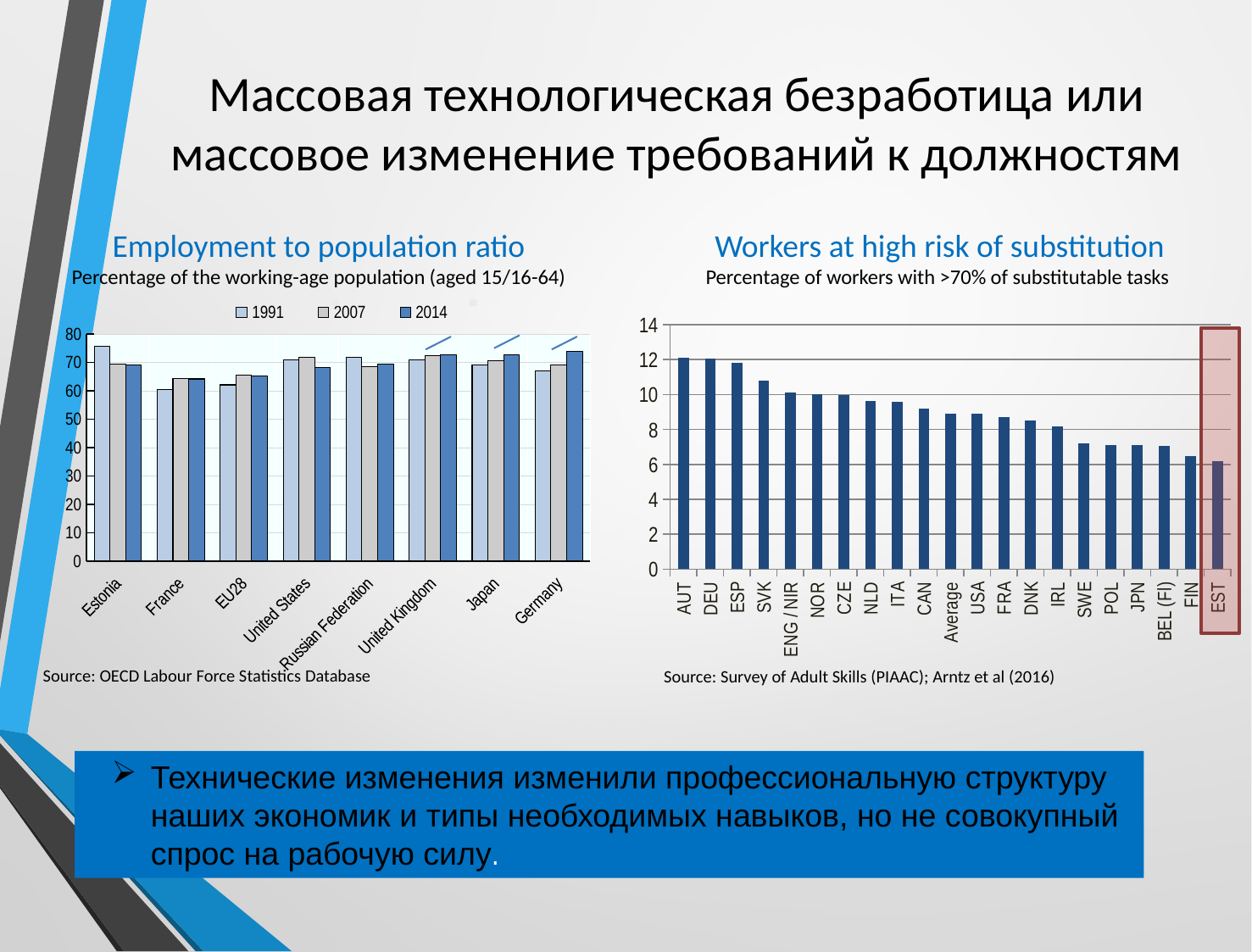
In the 'Workers at high risk of substitution' chart, do the values rise or fall from left to right along the x axis? fall In the 'Employment to population ratio' chart, is the 1991 value for Estonia greater or less than 70? greater How many series does the legend of the 'Employment to population ratio' chart list? 3 What kind of chart is the 'Employment to population ratio' chart? bar chart In the 'Workers at high risk of substitution' chart, is the value for EST greater or less than 8? less How many countries/categories are shown on the x axis of the 'Workers at high risk of substitution' chart? 21 How many countries/regions are shown on the x axis of the 'Employment to population ratio' chart? 8 What kind of chart is the 'Workers at high risk of substitution' chart? bar chart In the 'Employment to population ratio' chart, is the 1991 value for France greater or less than 70? less In the 'Employment to population ratio' chart, which country has the larger 1991 value: Estonia or France? Estonia In the 'Employment to population ratio' chart, which is larger for Germany: the 1991 value or the 2014 value? 2014